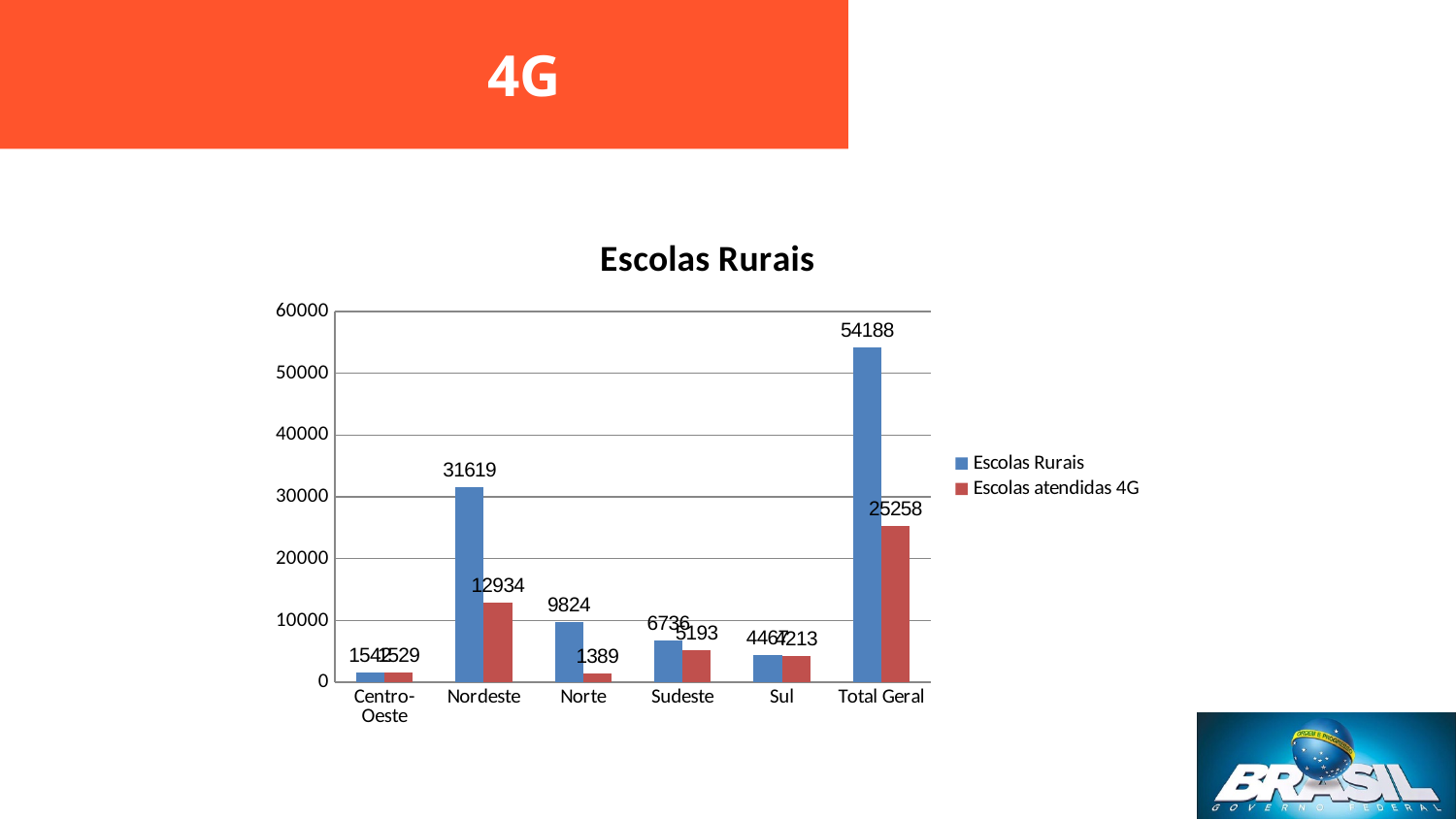
What is the difference between Escolas Rurais and Escolas atendidas 4G for Nordeste? 18685 What is the Escolas atendidas 4G value for Norte? 1389 How many categories are shown on the x axis? 6 What is the Escolas Rurais value for Nordeste? 31619 What is the Escolas Rurais value for Norte? 9824 Which category has the lowest Escolas Rurais value? Centro-Oeste Which has a larger Escolas atendidas 4G value, Nordeste or Sudeste? Nordeste Is the Escolas Rurais value for Sul greater or less than 10000? less How many series does the legend list? 2 Which category has the highest Escolas Rurais value? Total Geral What is the difference between Escolas Rurais and Escolas atendidas 4G for Total Geral? 28930 What is the Escolas atendidas 4G value for Total Geral? 25258